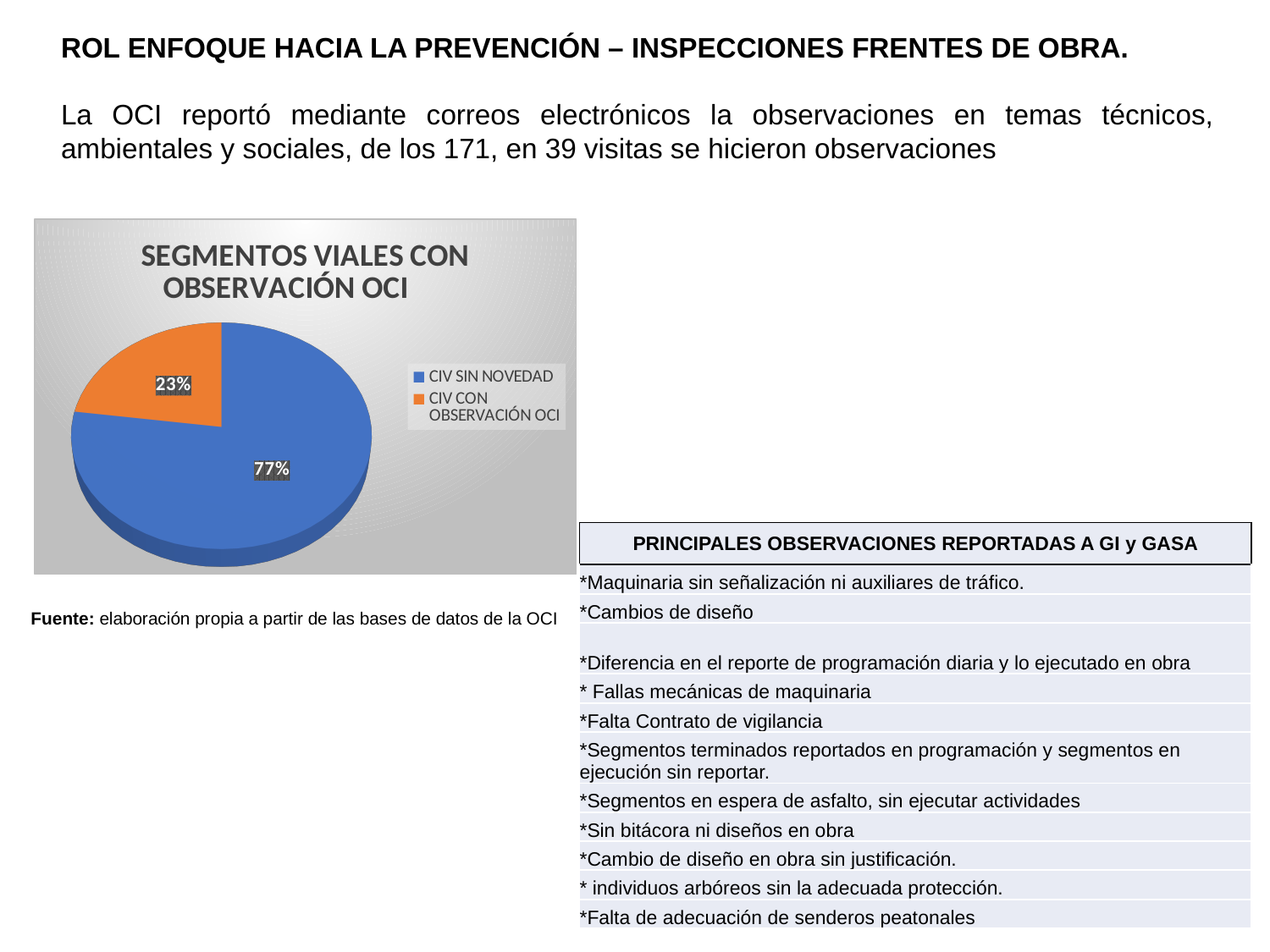
Which slice is the largest in the pie chart? CIV SIN NOVEDAD What percentage of the pie is CIV CON OBSERVACIÓN OCI? 23% What is the difference in percentage points between CIV SIN NOVEDAD and CIV CON OBSERVACIÓN OCI? 54 percentage points What percentage of the pie is CIV SIN NOVEDAD? 77% What kind of chart is shown on the slide? Pie chart What colour is the CIV CON OBSERVACIÓN OCI slice? Orange How many entries does the legend list? 2 What is the title of the chart? SEGMENTOS VIALES CON OBSERVACIÓN OCI Which slice is the smallest in the pie chart? CIV CON OBSERVACIÓN OCI How many slices does the pie chart have? 2 Is the share for CIV CON OBSERVACIÓN OCI greater or less than 50%? less Which is larger, the share for CIV SIN NOVEDAD or for CIV CON OBSERVACIÓN OCI? CIV SIN NOVEDAD